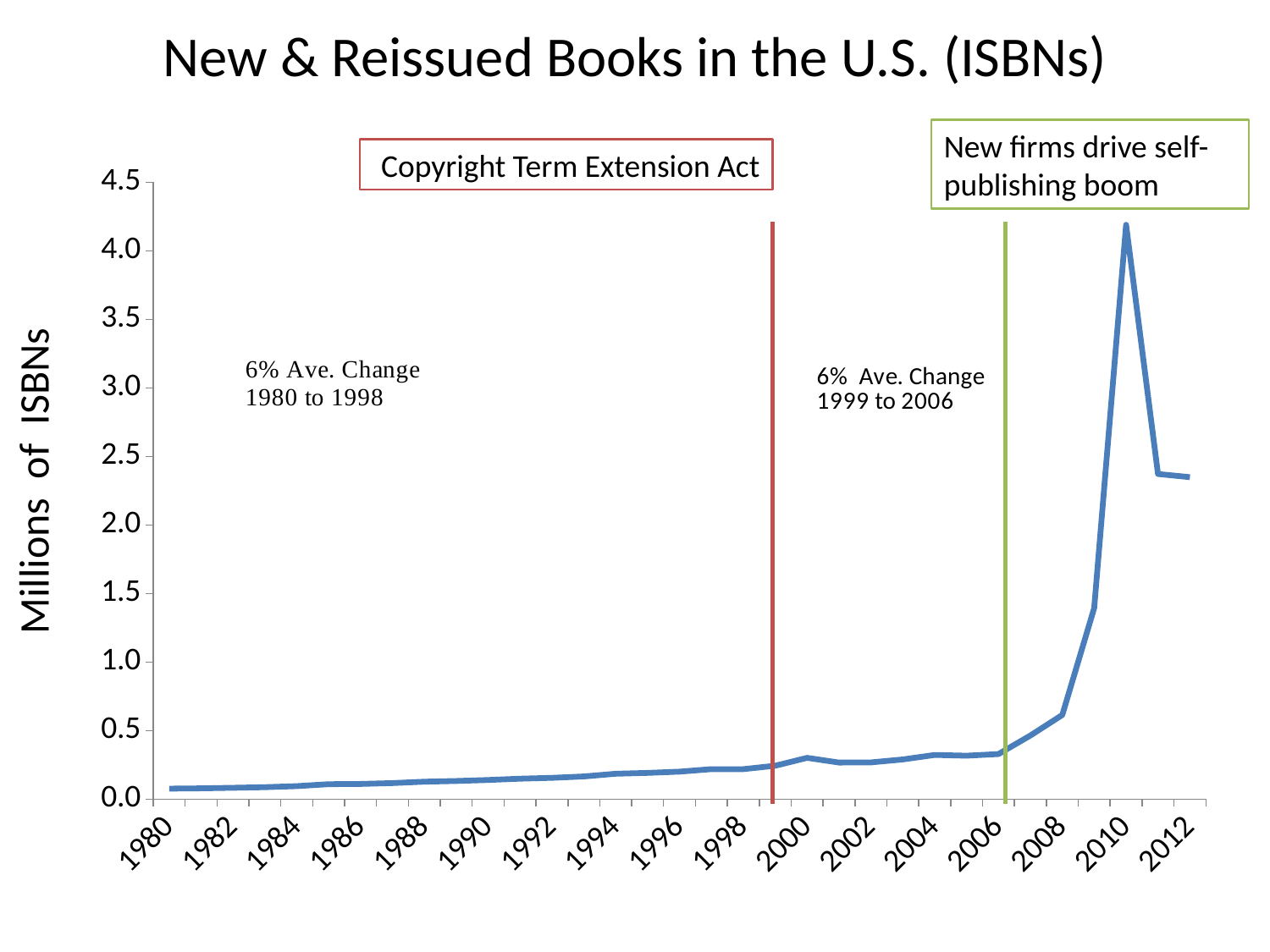
In which year does the line reach its highest value? 2010 Which year has the larger value, 2010 or 2012? 2010 What kind of chart is shown on the slide? line chart What is the title of the chart? New & Reissued Books in the U.S. (ISBNs) In which year is the value on the line lowest? 1980 Does the line generally rise or fall from 1980 to 2010? rise Is the value for 2012 greater or less than 2.5? less Is the value for 2010 greater or less than 4.0? greater Which year has the larger value, 2008 or 2009? 2009 Is the value for 2008 greater or less than 1.0? less What is the label on the y axis of the chart? Millions of ISBNs